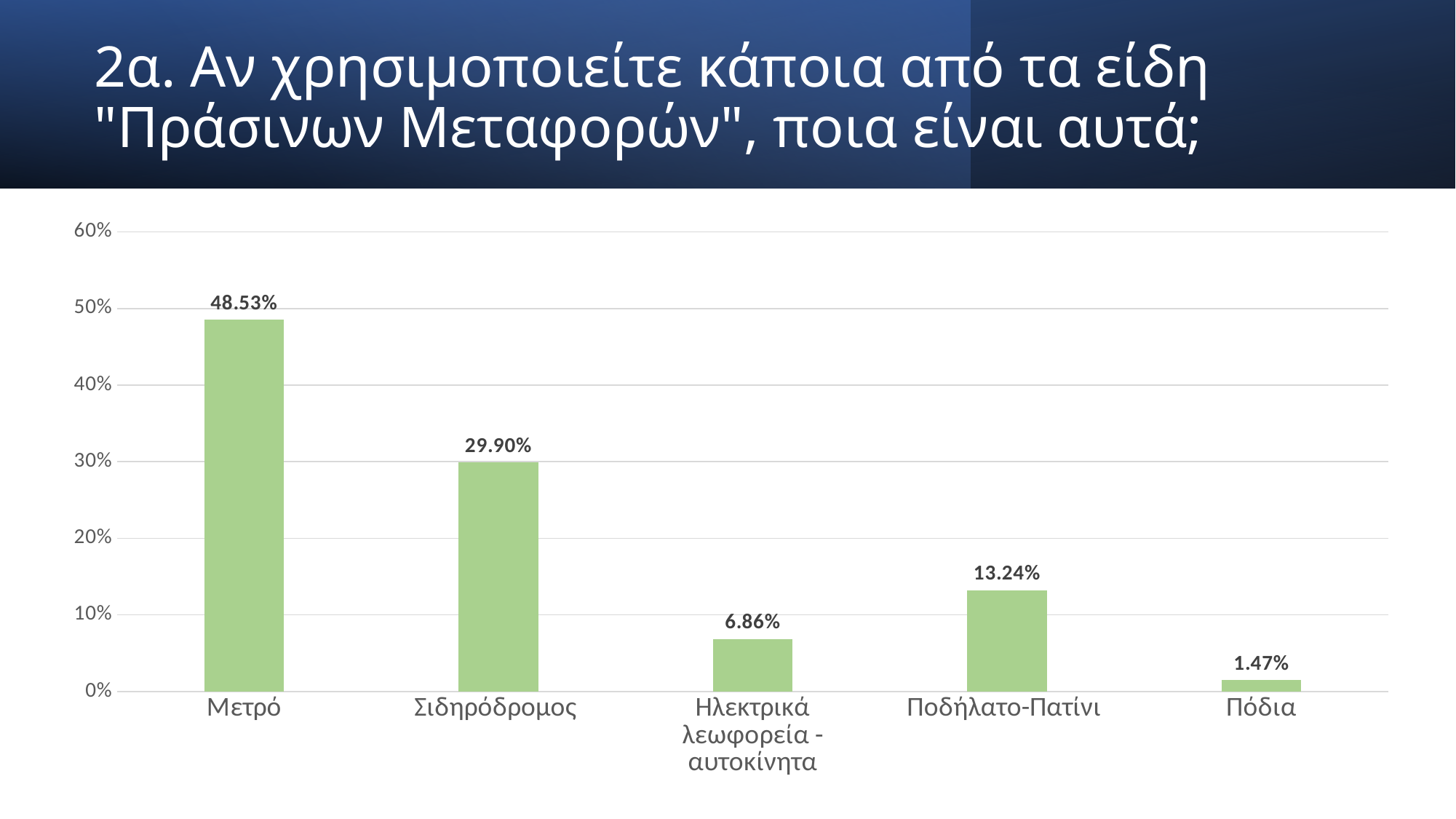
Which category has the highest value? Μετρό What is the value for Σιδηρόδρομος? 29.90% What is the value for Ποδήλατο-Πατίνι? 13.24% How many categories are shown on the chart? 5 Is the value for Σιδηρόδρομος greater or less than 20%? greater What is the value for Πόδια? 1.47% What is the value for Ηλεκτρικά λεωφορεία - αυτοκίνητα? 6.86% What is the value for Μετρό? 48.53% What is the difference between the values for Μετρό and Σιδηρόδρομος? 18.63% Which is larger, the value for Ποδήλατο-Πατίνι or the value for Ηλεκτρικά λεωφορεία - αυτοκίνητα? Ποδήλατο-Πατίνι What kind of chart is shown on the slide? bar chart Which category has the lowest value? Πόδια